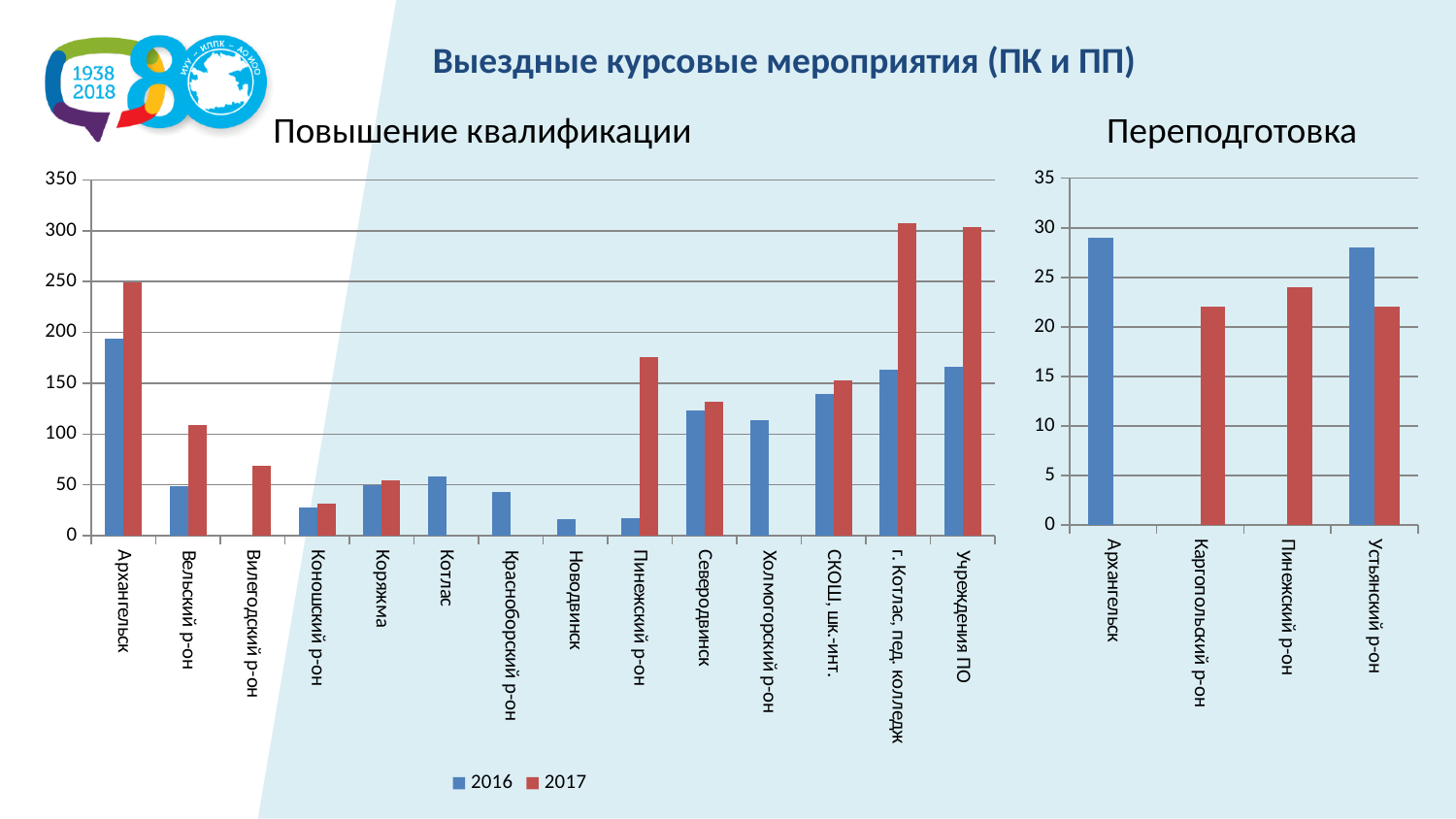
On the 'Повышение квалификации' chart, is the 2017 value for Вилегодский р-он greater or less than 100? less On the 'Повышение квалификации' chart, how many categories are shown on the x axis? 14 On the 'Повышение квалификации' chart, is the 2017 value for Учреждения ПО greater or less than 250? greater On the 'Повышение квалификации' chart, what kind of chart is shown? bar chart On the 'Повышение квалификации' chart, is the 2017 value for Архангельск greater or less than 200? greater On the 'Повышение квалификации' chart, which category has the highest value for 2016? Архангельск On the 'Переподготовка' chart, how many categories are shown on the x axis? 4 On the 'Переподготовка' chart, which is larger for Устьянский р-он: the 2016 value or the 2017 value? 2016 How many series does the legend list? 2 What are the two series named in the legend? 2016 and 2017 On the 'Повышение квалификации' chart, which is larger for Пинежский р-он: the 2016 value or the 2017 value? 2017